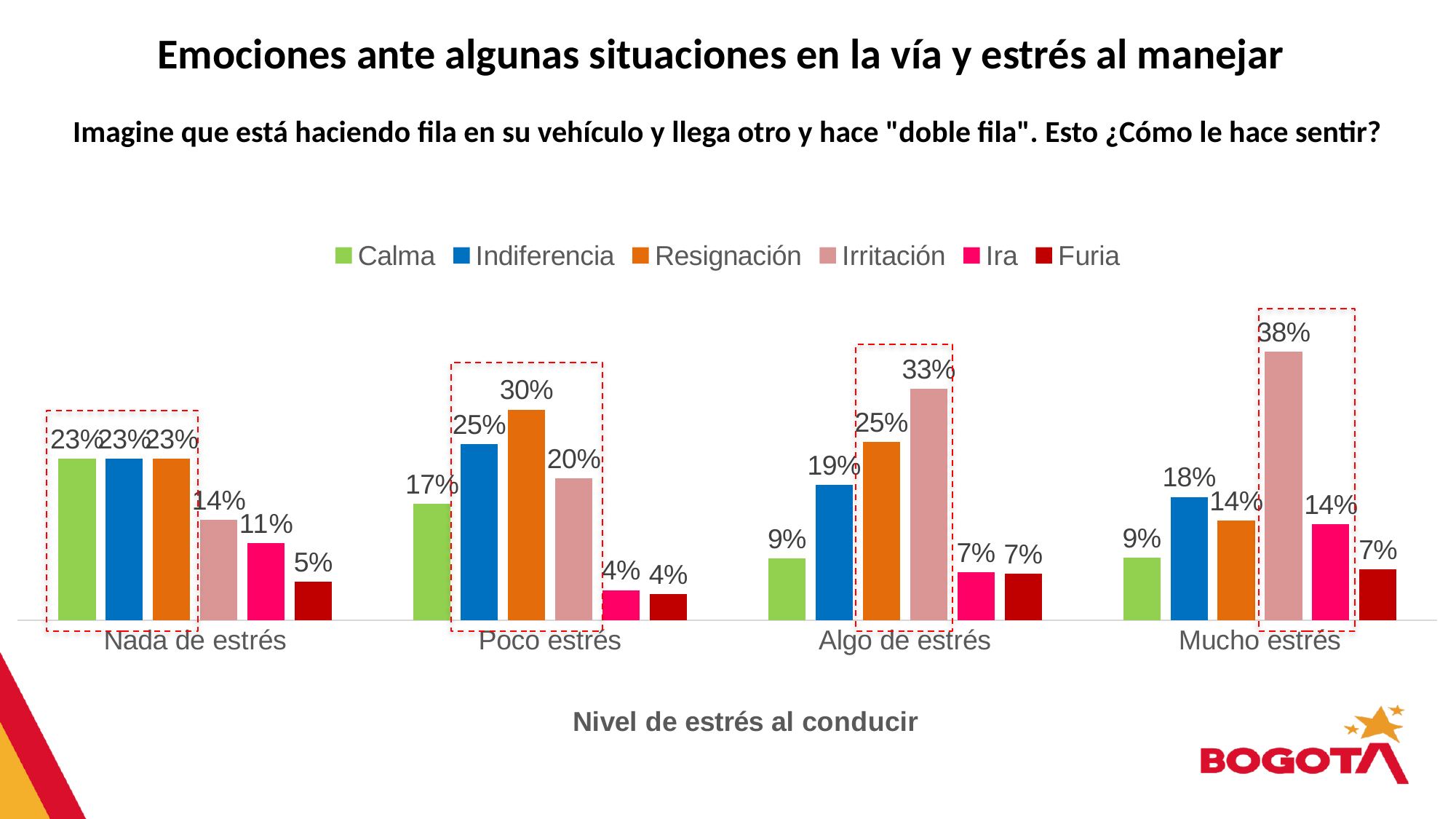
How many series does the legend list? 6 What is the x-axis title of the chart? Nivel de estrés al conducir What is the value for Ira in the Nada de estrés group? 11% Which emotion has the lowest value in the Nada de estrés group? Furia What is the value for Calma in the Algo de estrés group? 9% Which emotion has the highest value in the Algo de estrés group? Irritación Which is larger in the Poco estrés group, Indiferencia or Irritación? Indiferencia What kind of chart is shown on the slide? Bar chart What is the value for Resignación in the Poco estrés group? 30% What is the difference between Irritación and Indiferencia in the Mucho estrés group? 20% What is the value for Irritación in the Mucho estrés group? 38% How many stress-level categories are shown on the x axis? 4